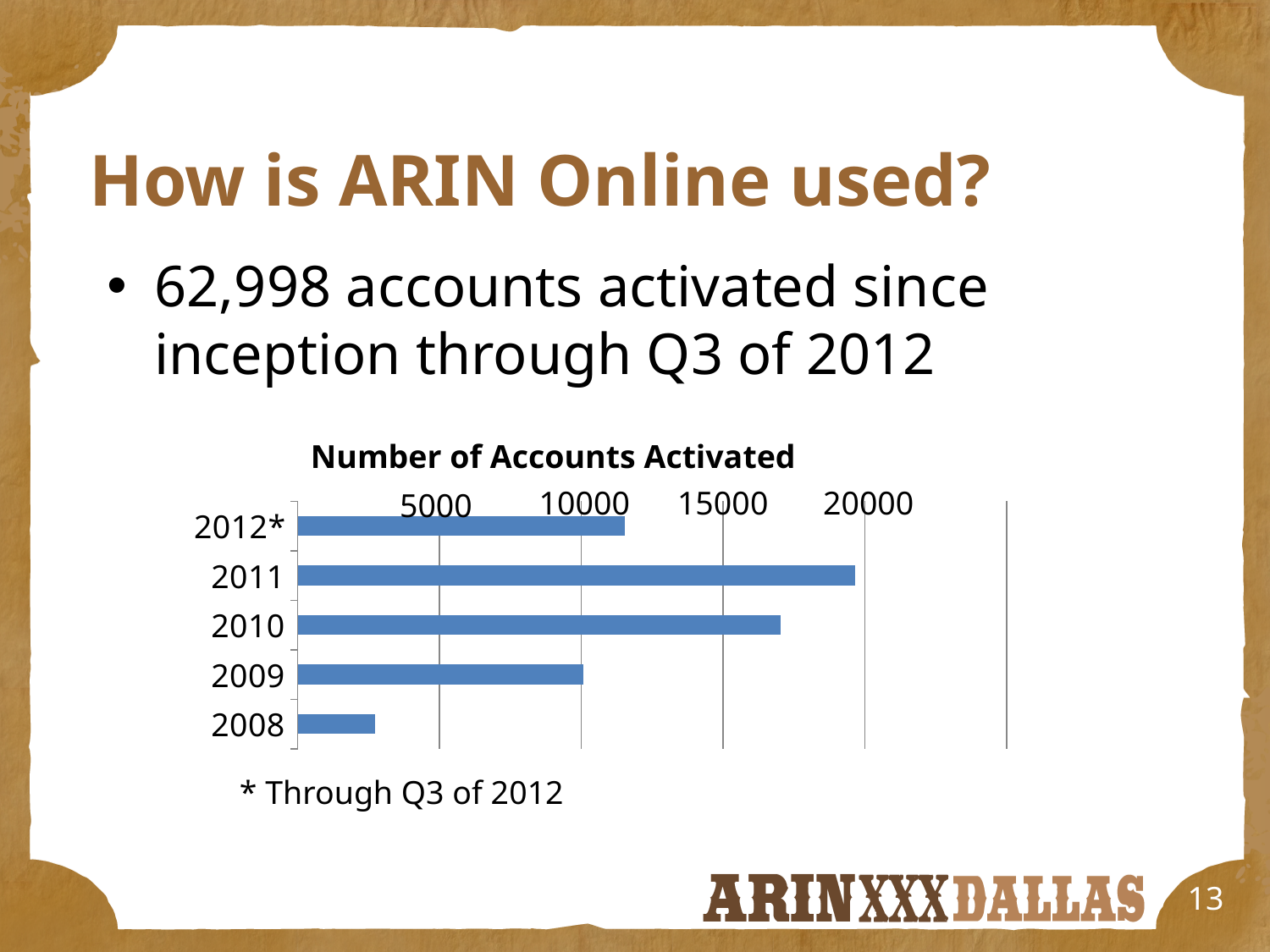
What is the title of the chart? Number of Accounts Activated Is the value for 2010 greater or less than 15000? greater Is the value for 2008 greater or less than 5000? less Do the number of accounts activated rise or fall from 2008 to 2011? rise Is the value for 2011 greater or less than 20000? less Which year has more accounts activated, 2012* or 2009? 2012* What kind of chart is shown on the slide? bar chart How many years (categories) are shown in the chart? 5 Which year has the highest number of accounts activated? 2011 Which year has the lowest number of accounts activated? 2008 Which year has more accounts activated, 2011 or 2010? 2011